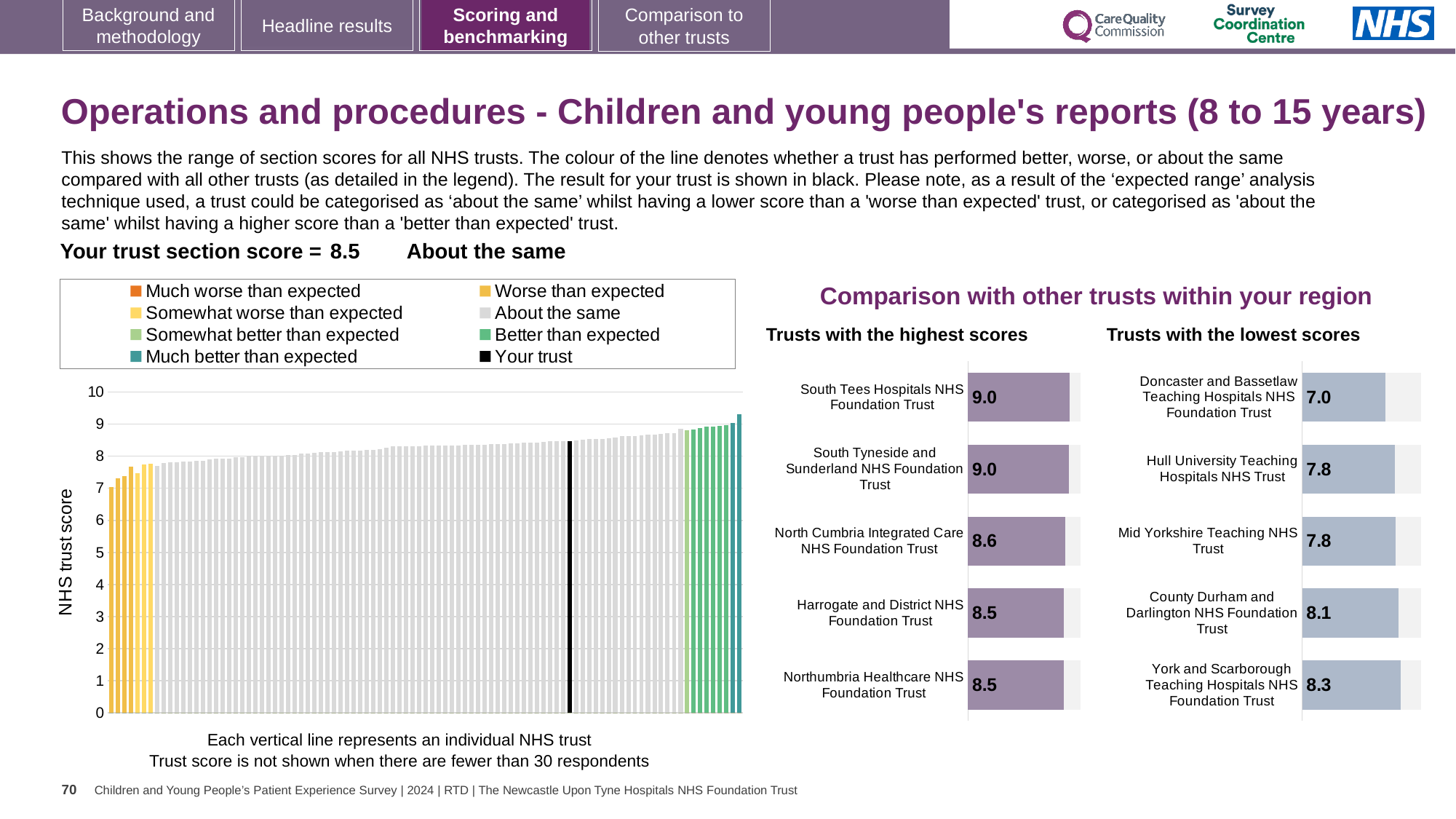
In the 'Trusts with the lowest scores' chart, which has the higher score: Hull University Teaching Hospitals NHS Trust or County Durham and Darlington NHS Foundation Trust? County Durham and Darlington NHS Foundation Trust In the 'Trusts with the lowest scores' chart, what is the score for York and Scarborough Teaching Hospitals NHS Foundation Trust? 8.3 What kind of chart is the large chart on the left showing NHS trust scores? Bar chart How many entries does the legend above the large chart on the left list? 8 What is the y-axis label of the large chart on the left? NHS trust score How many trusts are listed in the 'Trusts with the highest scores' chart? 5 In the 'Trusts with the highest scores' chart, what is the score for North Cumbria Integrated Care NHS Foundation Trust? 8.6 In the 'Trusts with the lowest scores' chart, which trust has the lowest score? Doncaster and Bassetlaw Teaching Hospitals NHS Foundation Trust In the 'Trusts with the lowest scores' chart, what is the score for Doncaster and Bassetlaw Teaching Hospitals NHS Foundation Trust? 7.0 In the large chart on the left, do the trust scores rise or fall from left to right? Rise In the 'Trusts with the lowest scores' chart, what is the difference between the scores of York and Scarborough Teaching Hospitals NHS Foundation Trust and Doncaster and Bassetlaw Teaching Hospitals NHS Foundation Trust? 1.3 In the 'Trusts with the highest scores' chart, what is the difference between the scores of North Cumbria Integrated Care NHS Foundation Trust and Harrogate and District NHS Foundation Trust? 0.1